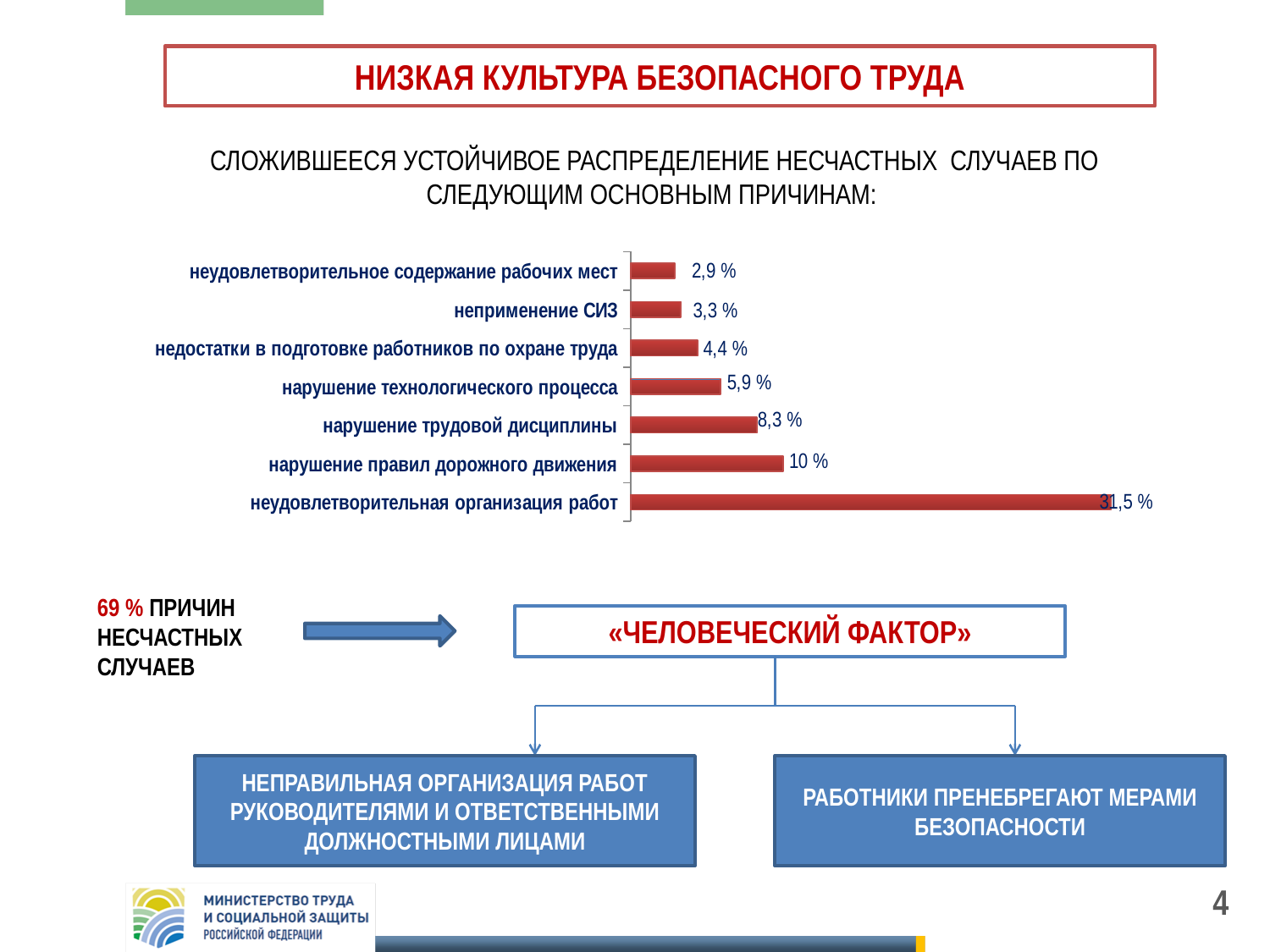
Which category has the highest value? неудовлетворительная организация работ Do the bar values increase or decrease going from the top category to the bottom category? increase What is the value for «нарушение технологического процесса»? 5,9 % What kind of chart is shown on the slide? bar chart What is the difference between «нарушение трудовой дисциплины» and «недостатки в подготовке работников по охране труда»? 3,9 % What is the difference between «неудовлетворительная организация работ» and «нарушение правил дорожного движения»? 21,5 % Which category has the lowest value? неудовлетворительное содержание рабочих мест What is the value for «неприменение СИЗ»? 3,3 % Which is larger: «нарушение трудовой дисциплины» or «нарушение технологического процесса»? нарушение трудовой дисциплины What is the value for «нарушение правил дорожного движения»? 10 % What is the value for «неудовлетворительная организация работ»? 31,5 % How many categories are shown in the chart? 7